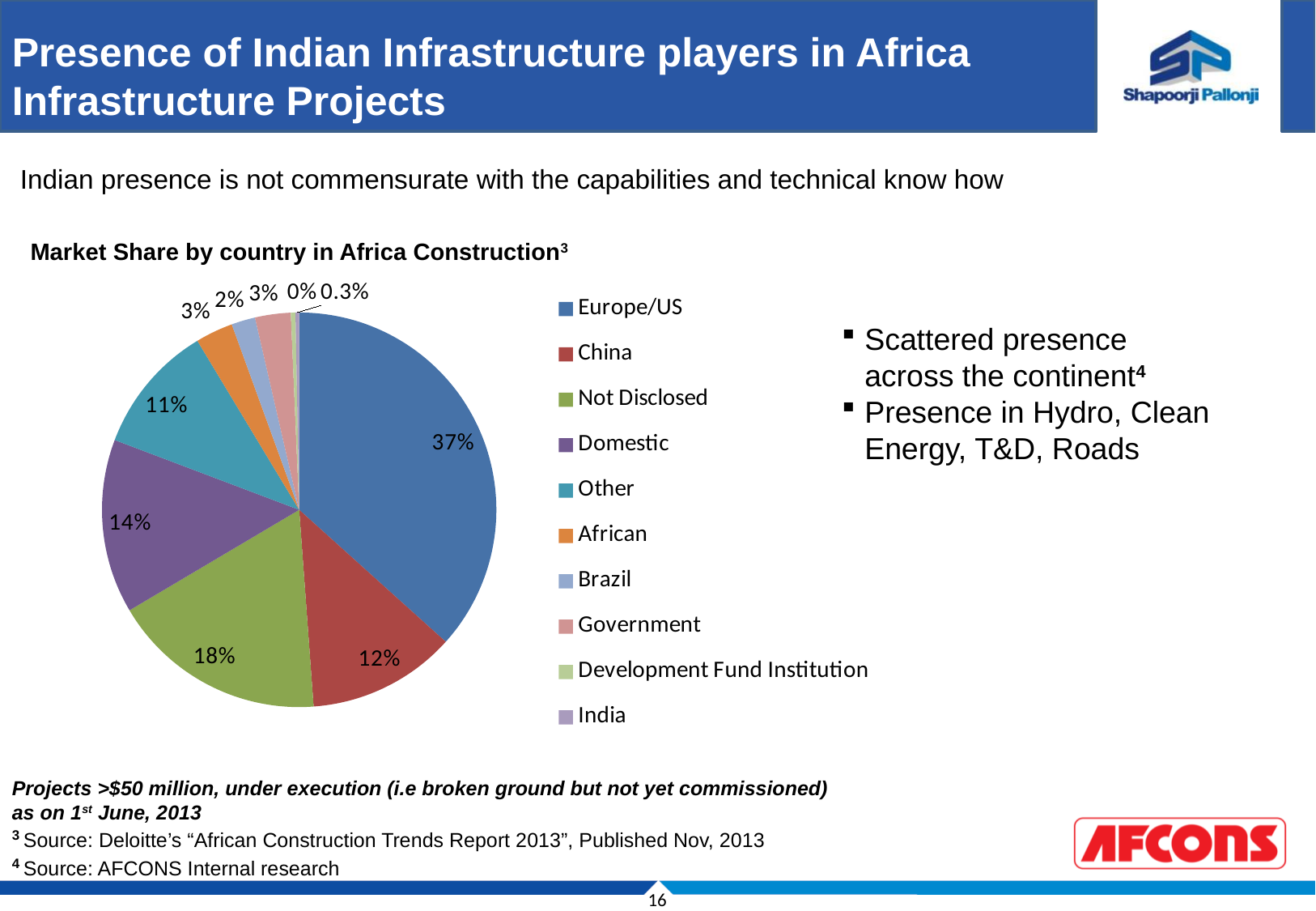
What is the market share for Brazil in the pie chart? 2% What is the difference in market share between Europe/US and China? 25% What is the title of the pie chart? Market Share by country in Africa Construction Which has a larger market share, Not Disclosed or Domestic? Not Disclosed What is the market share for China in the pie chart? 12% What is the market share for Domestic in the pie chart? 14% Which category has the largest share in the pie chart? Europe/US What is the market share for Other in the pie chart? 11% How many categories does the legend of the pie chart list? 10 What is the market share for Europe/US in the pie chart? 37% What type of chart is shown on the slide? pie chart What is the market share for Not Disclosed in the pie chart? 18%